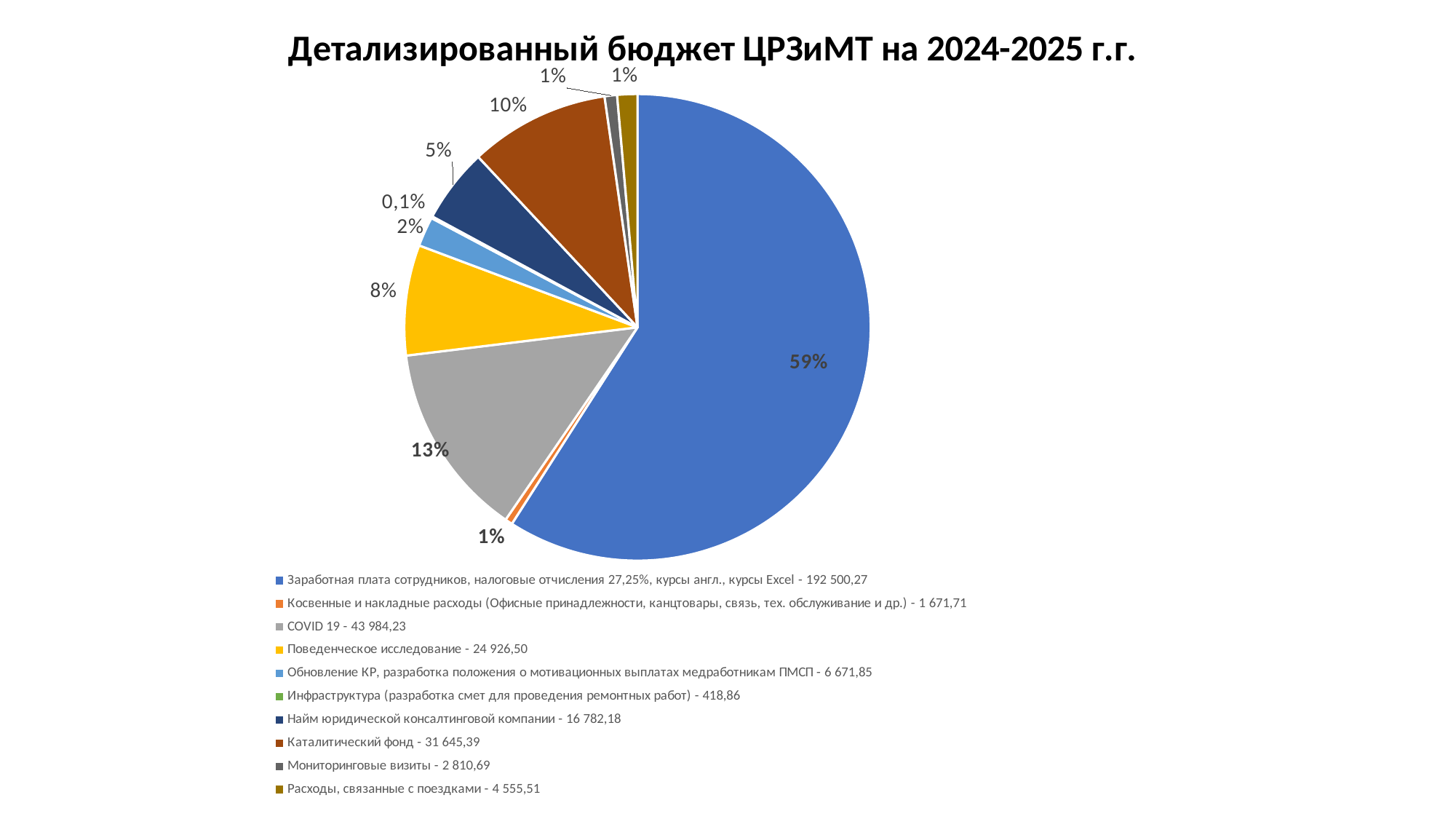
What is the title of the chart? Детализированный бюджет ЦРЗиМТ на 2024-2025 г.г. How many categories does the legend list? 10 Which category has the largest slice of the pie? Заработная плата сотрудников, налоговые отчисления 27,25%, курсы англ., курсы Excel Which category has the smallest slice of the pie? Инфраструктура (разработка смет для проведения ремонтных работ) What share of the pie does the Поведенческое исследование slice represent? 8% What is the budget value shown in the legend for Каталитический фонд? 31 645,39 What is the difference in percentage points between the Заработная плата slice (59%) and the COVID 19 slice (13%)? 46 percentage points What share of the pie does the COVID 19 slice represent? 13% What is the budget value shown in the legend for Мониторинговые визиты? 2 810,69 What kind of chart is shown on the slide? Pie chart Which slice is larger: COVID 19 or Найм юридической консалтинговой компании? COVID 19 What share of the pie does the Каталитический фонд slice represent? 10%